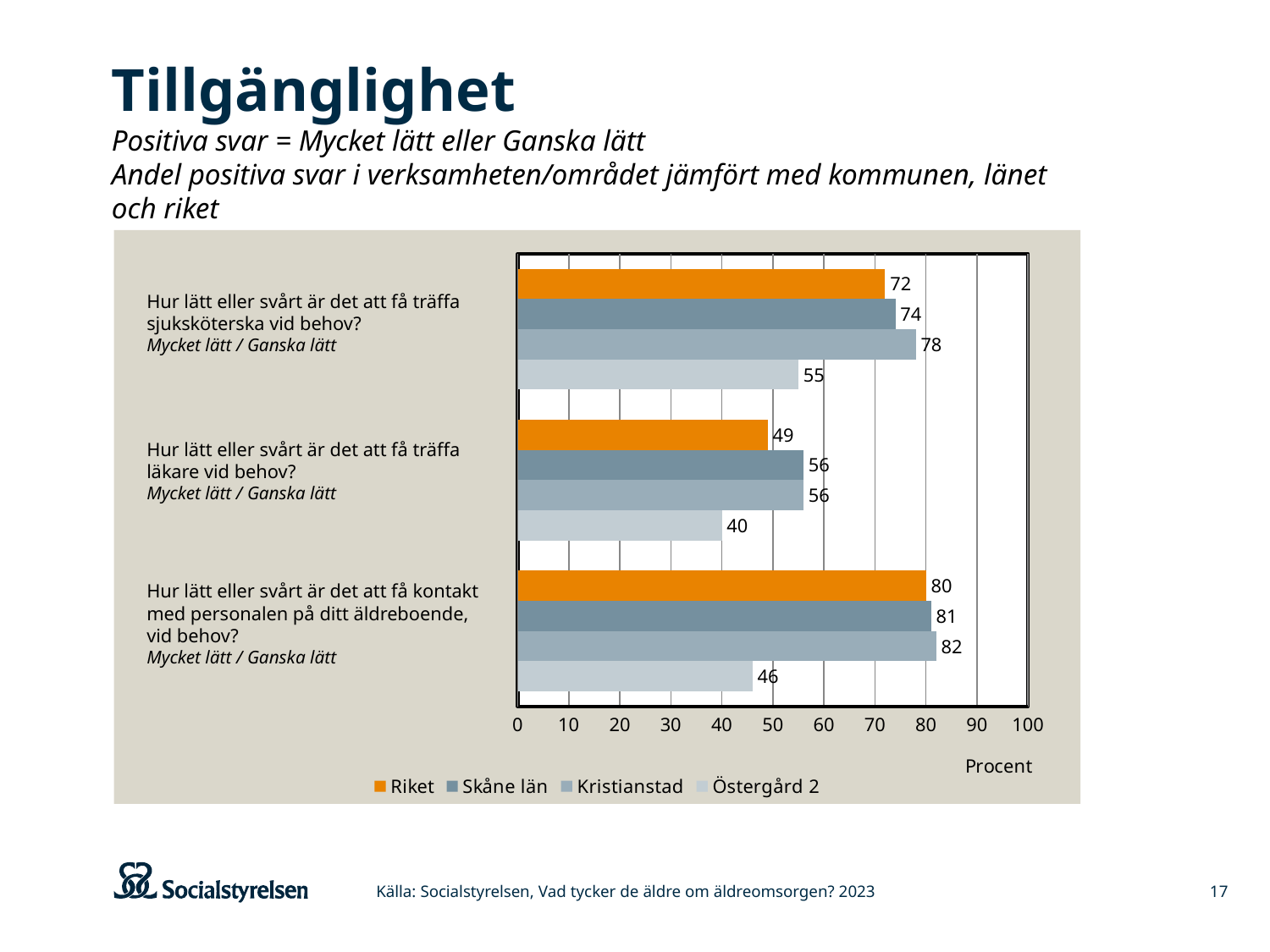
How many question categories are shown on the chart? 3 What is the label on the horizontal axis of the chart? Procent Which series has the lowest value on the question about getting to meet a doctor (läkare) when needed? Östergård 2 Is the value for Östergård 2 on the doctor (läkare) question greater or less than 50? less How many series does the legend list? 4 What is the value for Riket on the question about getting to meet a doctor (läkare) when needed? 49 What is the difference between Kristianstad and Östergård 2 on the question about getting in contact with staff at the care home? 36 What is the value for Östergård 2 on the question about getting to meet a nurse (sjuksköterska) when needed? 55 Which is larger on the nurse (sjuksköterska) question: Riket or Östergård 2? Riket Which series has the highest value on the question about getting to meet a nurse (sjuksköterska) when needed? Kristianstad What kind of chart is shown on the slide? Bar chart What is the value for Kristianstad on the question about getting in contact with staff at the care home (kontakt med personalen)? 82